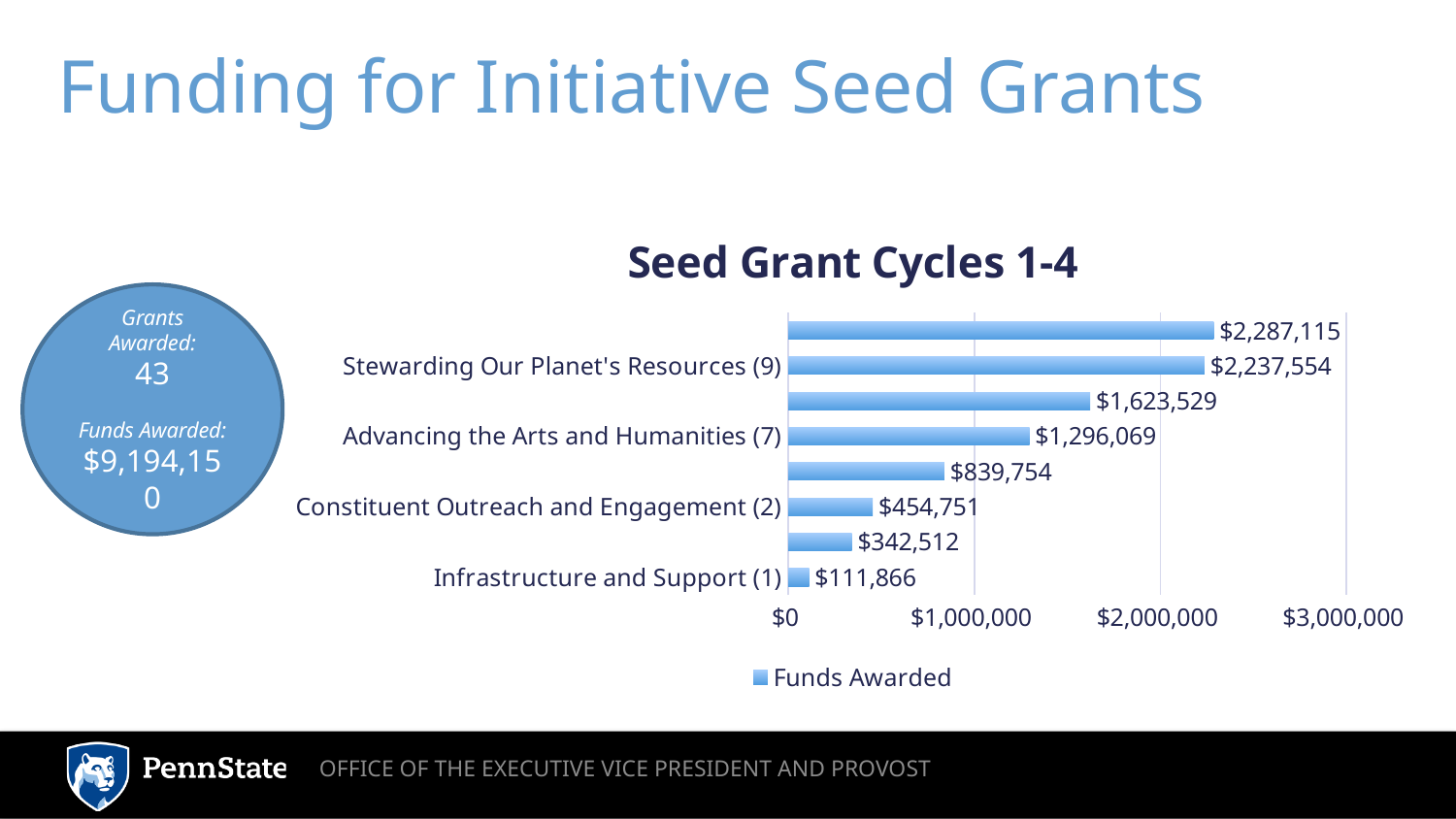
What is the difference between Stewarding Our Planet's Resources (9) and Advancing the Arts and Humanities (7)? $941,485 What is the value of the longest bar in the chart? $2,287,115 What is the value for Constituent Outreach and Engagement (2)? $454,751 Which labeled category has the lowest value, and what is it? Infrastructure and Support (1), $111,866 Do the bar values increase or decrease from the top of the chart to the bottom? Decrease What is the value for Stewarding Our Planet's Resources (9)? $2,237,554 How many bars are plotted in the chart? 8 What is the title of the chart? Seed Grant Cycles 1-4 Which is larger: Advancing the Arts and Humanities (7) or Constituent Outreach and Engagement (2)? Advancing the Arts and Humanities (7) What kind of chart is shown on the slide? Bar chart What is the value for Advancing the Arts and Humanities (7)? $1,296,069 How many series does the chart legend list? 1